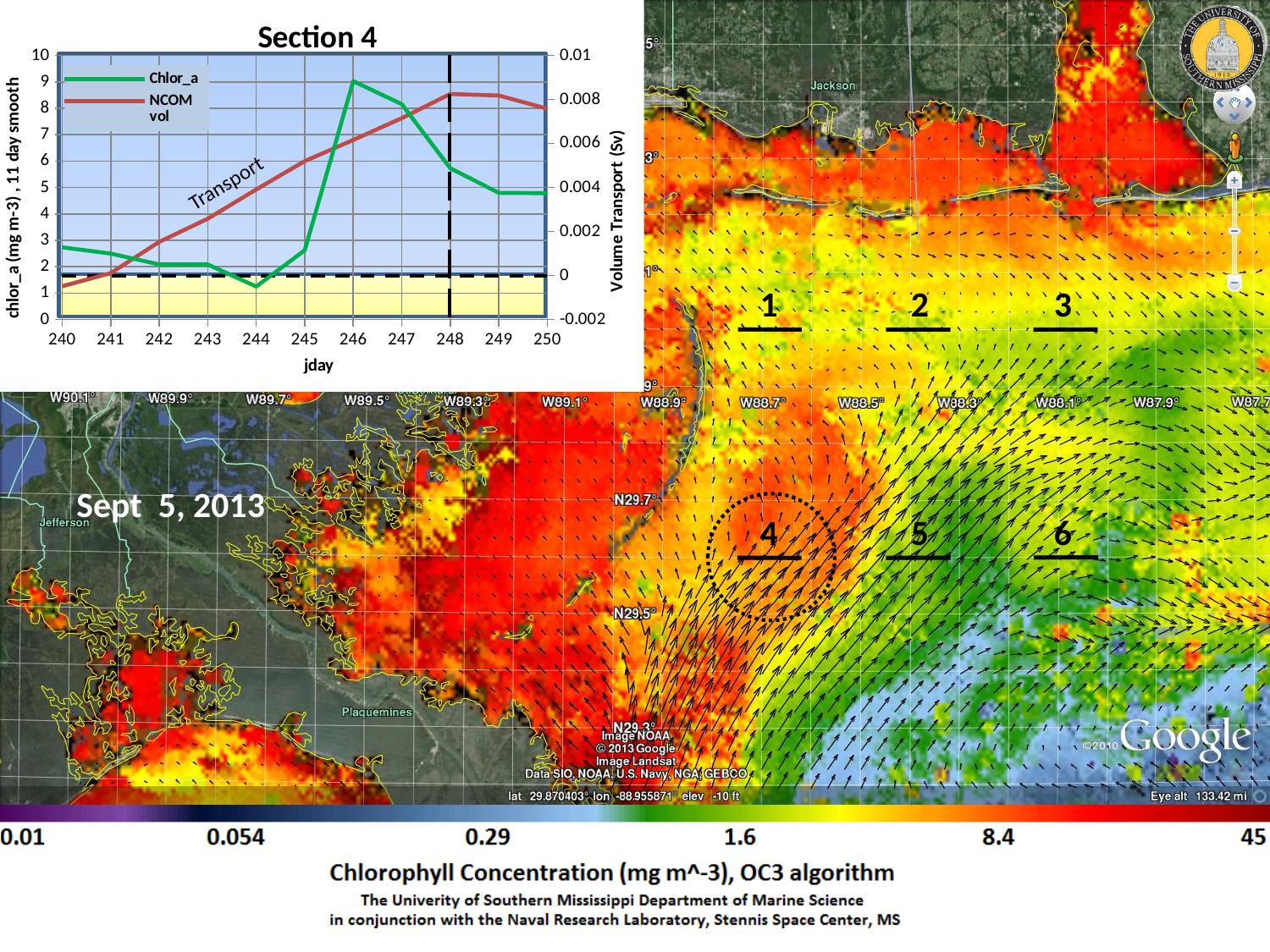
How many series does the legend of the 'Section 4' chart list? 2 On the 'Section 4' chart, is the Chlor_a value at jday 244 greater or less than 2? less On the 'Section 4' chart, does Chlor_a rise or fall from jday 246 to jday 250? fall On the 'Section 4' chart, does NCOM vol rise or fall from jday 241 to jday 248? rise What kind of chart is the 'Section 4' chart? line chart On the 'Section 4' chart, which is larger: the Chlor_a value at jday 246 or at jday 240? jday 246 On the 'Section 4' chart, at which jday does Chlor_a reach its highest value? 246 What is the label of the x axis on the 'Section 4' chart? jday On the 'Section 4' chart, at which jday does Chlor_a reach its lowest value? 244 What are the two series named in the legend of the 'Section 4' chart? Chlor_a and NCOM vol On the 'Section 4' chart, is the Chlor_a value at jday 246 greater or less than 8? greater On the 'Section 4' chart, is the NCOM vol value at jday 248 greater or less than 0.006? greater